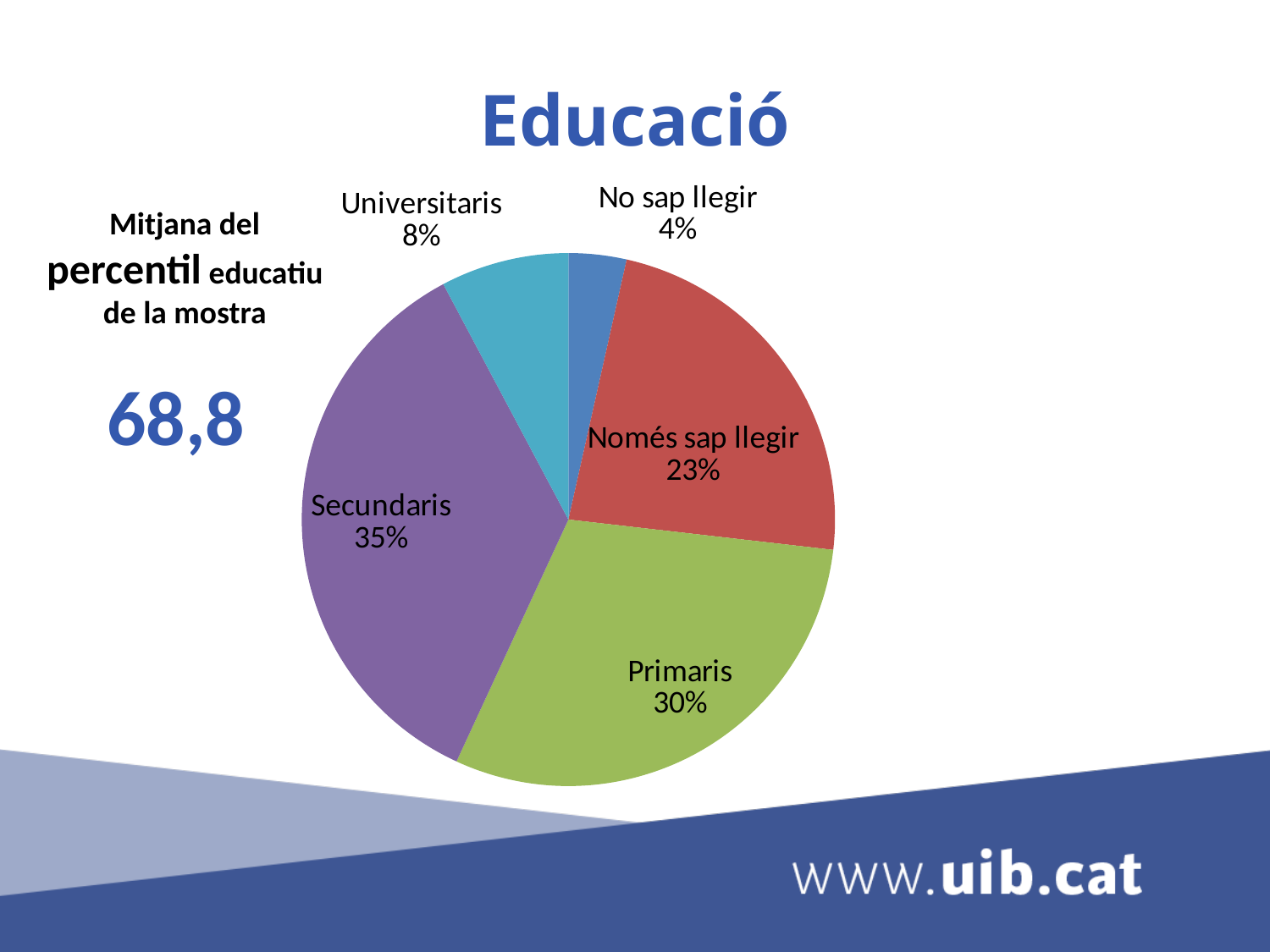
What is the value shown for No sap llegir? 4% Which is larger, Només sap llegir or Universitaris? Només sap llegir Which category has the largest slice of the pie? Secundaris What kind of chart is shown on the slide? pie chart Which category has the smallest slice of the pie? No sap llegir What is the difference between the Secundaris and Primaris shares? 5% What is the title of the slide containing the chart? Educació What share of the pie does Secundaris represent? 35% How many categories are shown in the pie chart? 5 What is the value shown for Només sap llegir? 23% What is the value shown for Universitaris? 8% What share of the pie does Primaris represent? 30%